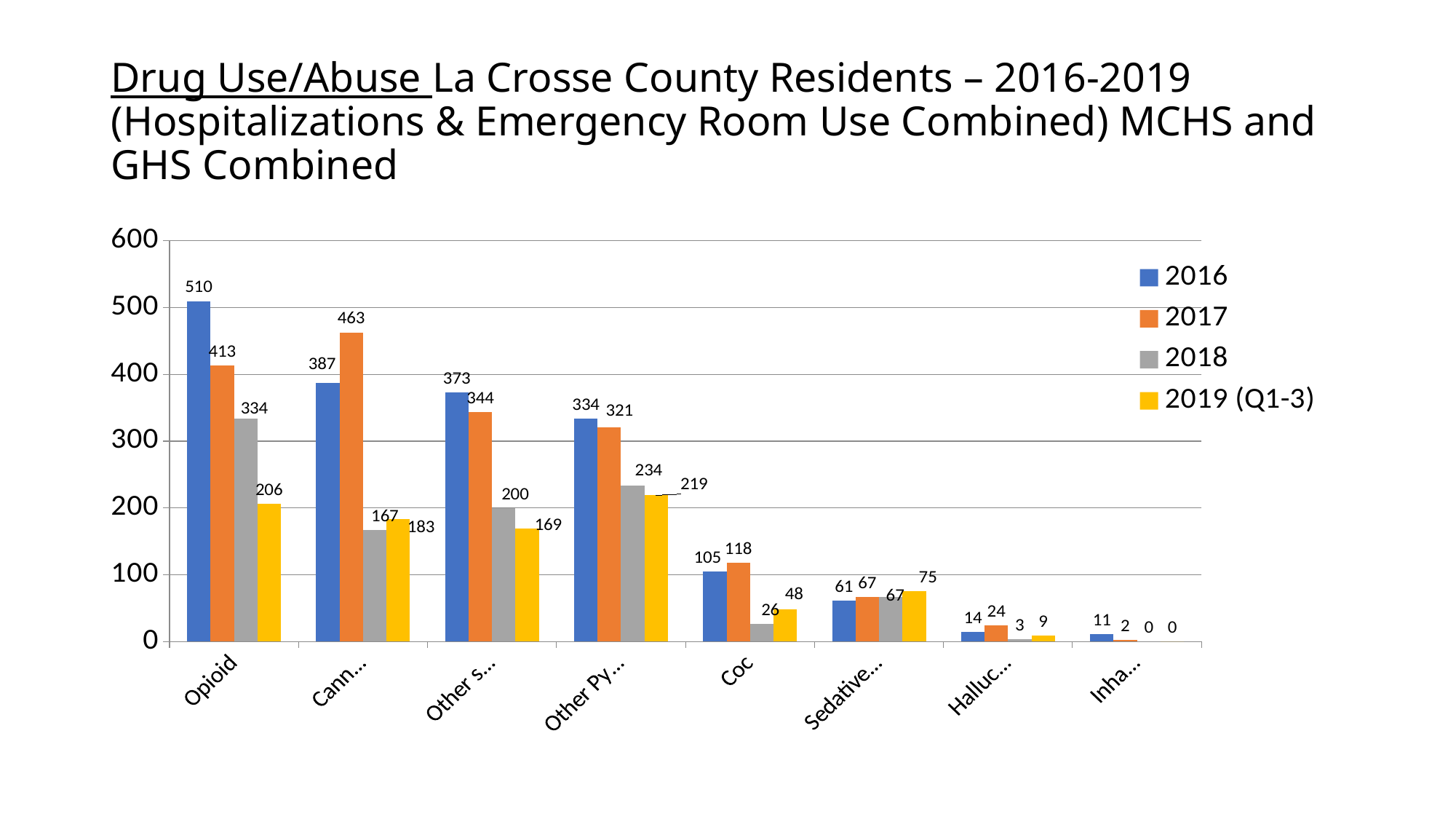
How many series does the legend list? 4 What is the 2018 value for Coc? 26 Which category has the highest 2016 value? Opioid How many drug categories are shown on the x axis? 8 What is the difference between the 2019 (Q1-3) and 2018 values for Coc? 22 What is the difference between the 2016 and 2017 values for Opioid? 97 What is the 2016 value for Opioid? 510 What kind of chart is shown on the slide? bar chart Do the Opioid values rise or fall from 2016 to 2019 (Q1-3)? fall For Coc, which year has the larger value, 2016 or 2017? 2017 What is the 2019 (Q1-3) value for Opioid? 206 What is the 2017 value for Coc? 118